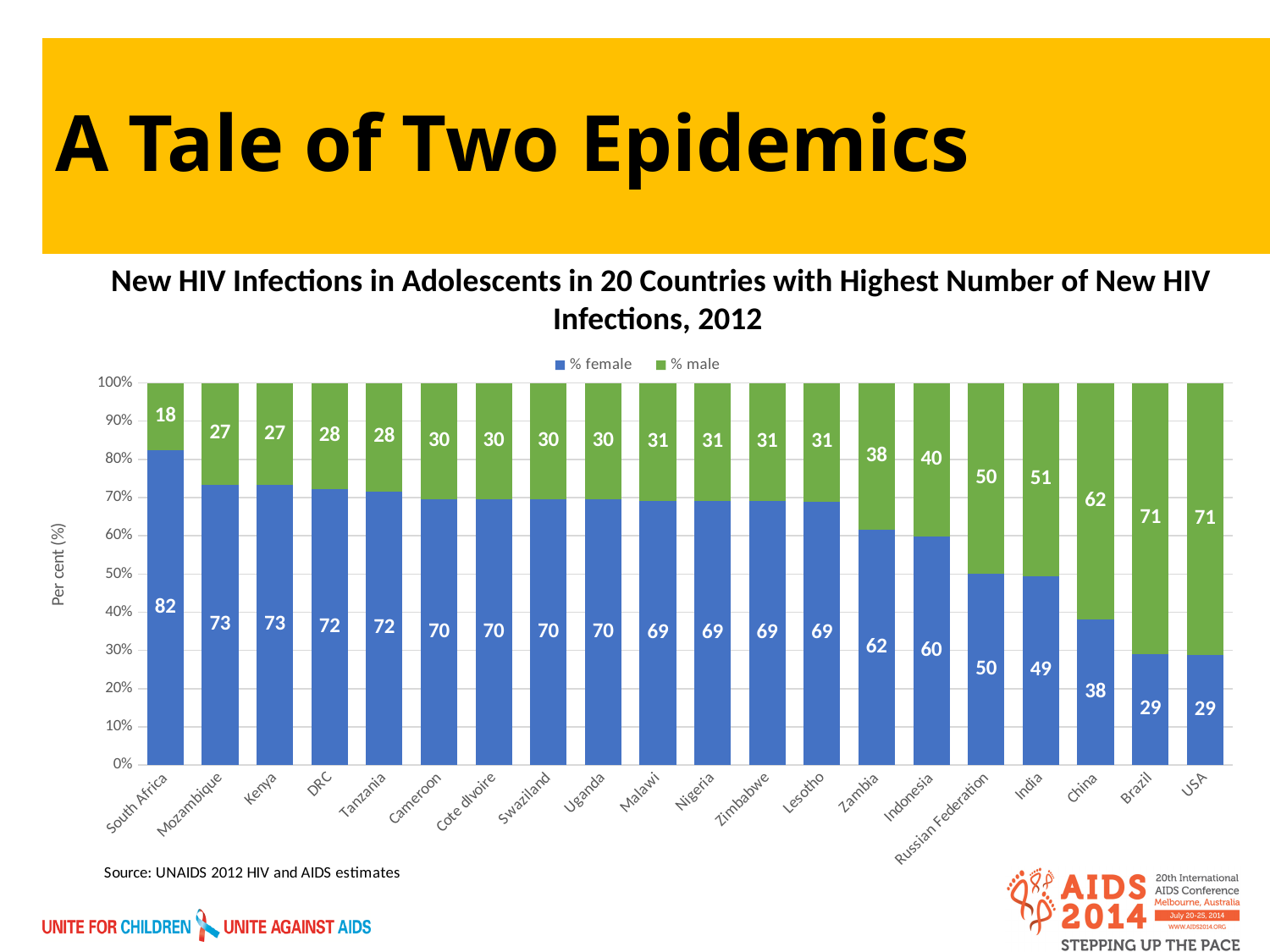
Which country has the lowest % male value? South Africa How many series does the legend list? 2 What is the % male value for China? 62 What kind of chart is shown on the slide? Stacked bar chart What is the difference between the % female values for Mozambique and India? 24 How many countries are shown on the x axis? 20 Which country has the highest % female value? South Africa Do the % female values rise or fall from South Africa to USA along the x axis? Fall What is the title of the chart? New HIV Infections in Adolescents in 20 Countries with Highest Number of New HIV Infections, 2012 What is the % female value for Indonesia? 60 Which is larger, the % male value for Zambia or the % male value for Russian Federation? Russian Federation What is the % female value for South Africa? 82